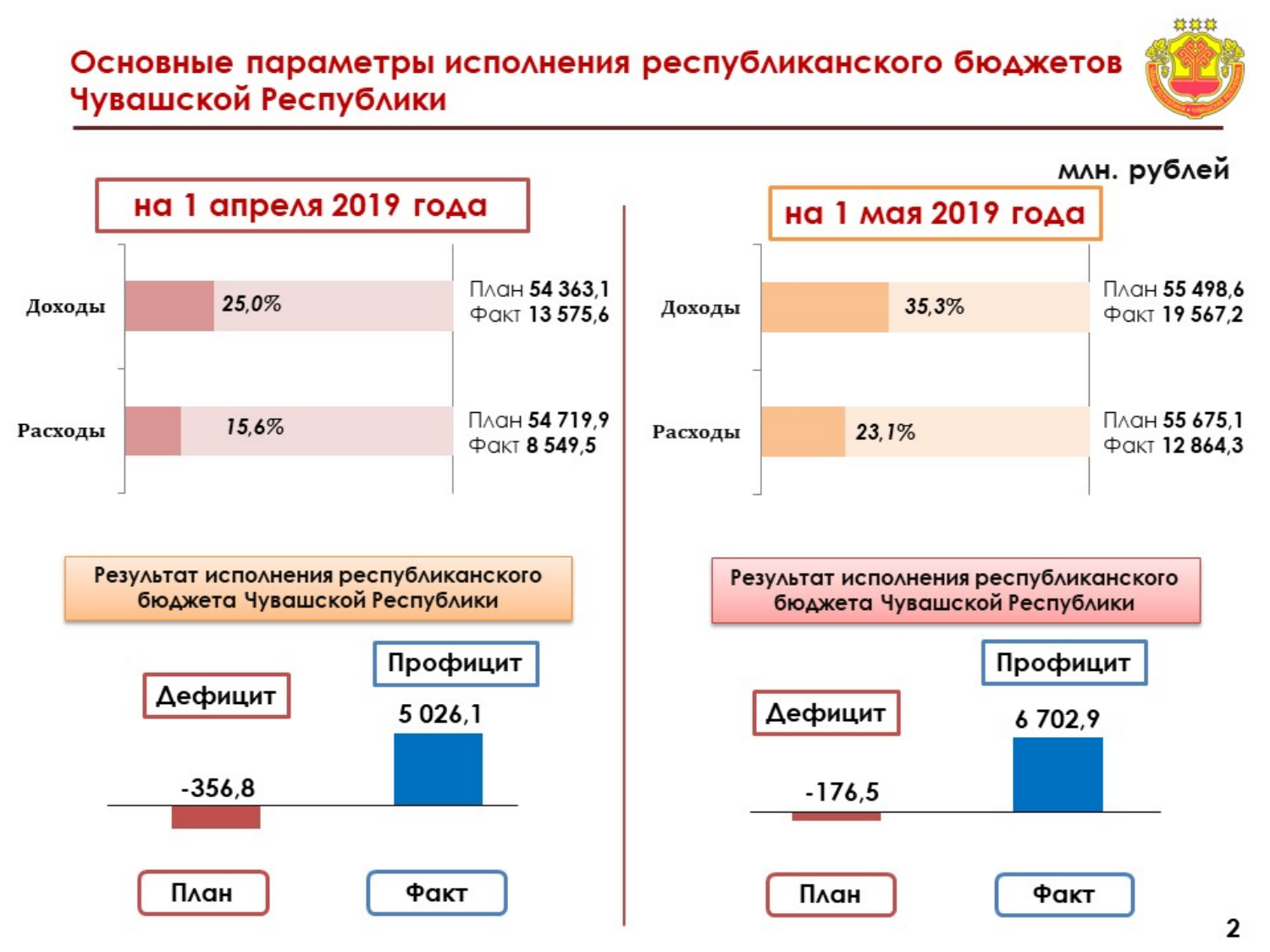
In the top-right chart (на 1 мая 2019 года), which category has the higher execution percentage, Доходы or Расходы? Доходы In the top-right chart (на 1 мая 2019 года), what percentage is shown for Расходы? 23,1% In the top-right chart (на 1 мая 2019 года), what is the План value for Доходы? 55 498,6 In the bottom-right chart (Результат исполнения, 1 мая), what is the Факт value? 6 702,9 What is the difference between the Факт values in the bottom-right chart (6 702,9) and the bottom-left chart (5 026,1)? 1 676,8 What type of chart is the top-left chart (на 1 апреля 2019 года)? Bar chart In the top-left chart (на 1 апреля 2019 года), what percentage is shown for Доходы? 25,0% In the bottom-left chart (Результат исполнения, 1 апреля), what is the План value? -356,8 In the bottom-left chart (Результат исполнения, 1 апреля), what is the Факт value? 5 026,1 How many categories are shown in the top-right chart (на 1 мая 2019 года)? 2 In the top-left chart (на 1 апреля 2019 года), what is the Факт value for Расходы? 8 549,5 What is the difference between the Доходы percentage in the top-right chart (35,3%) and in the top-left chart (25,0%)? 10,3 percentage points